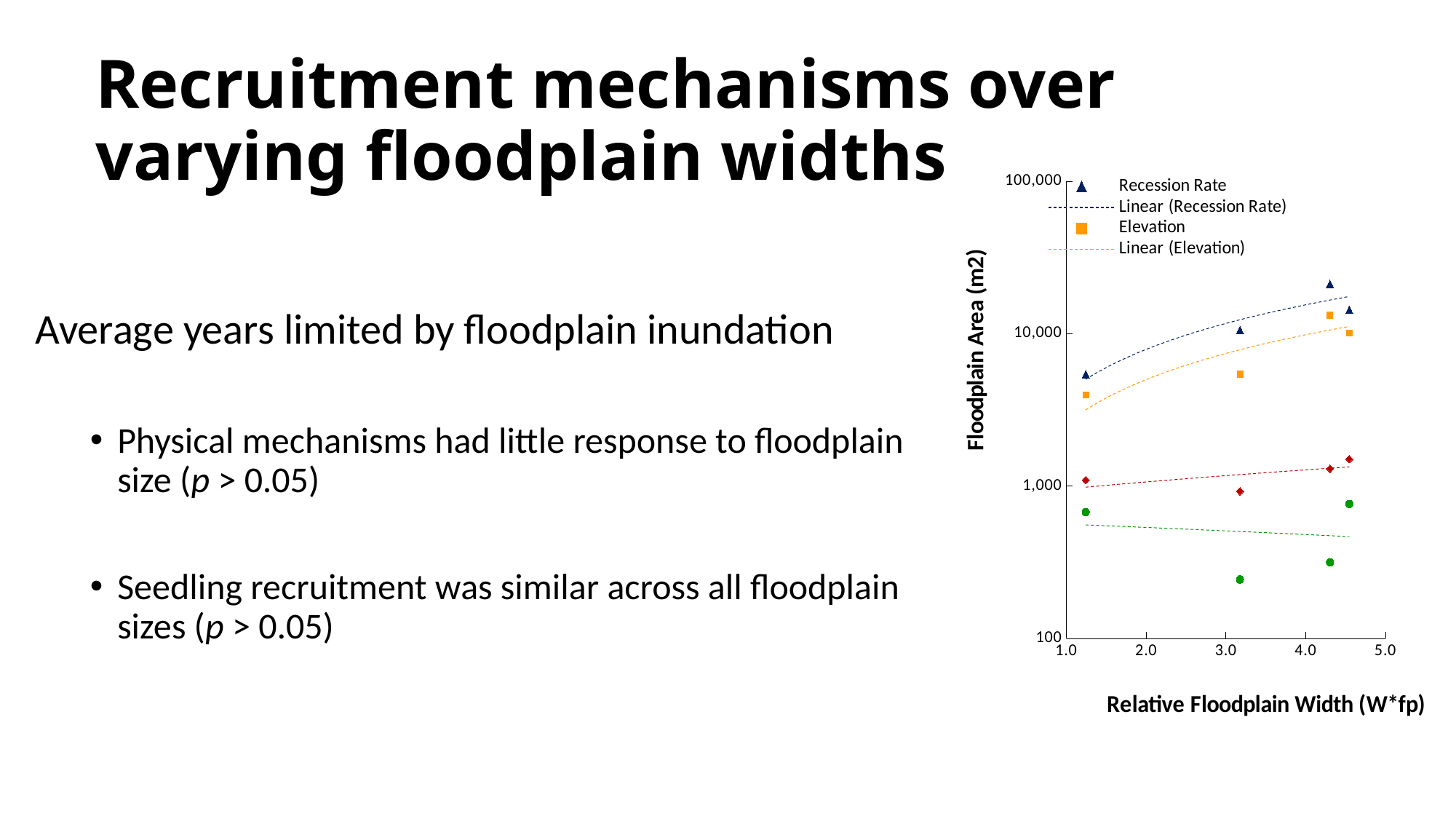
How many Recession Rate data points are plotted on the chart? 4 How many Elevation data points are plotted on the chart? 4 Is the highest Recession Rate point greater or less than 10,000 m2? greater What is the title of the chart's horizontal axis? Relative Floodplain Width (W*fp) What is the title of the chart's vertical axis? Floodplain Area (m2) Does the Linear (Elevation) trendline rise or fall as relative floodplain width increases? rise At a relative floodplain width of about 3.2, which is larger: the Recession Rate value or the Elevation value? Recession Rate What kind of chart is shown on the slide? scatter chart How many entries does the chart legend list? 4 Is the Elevation point at the smallest relative floodplain width greater or less than 10,000 m2? less Does the Linear (Recession Rate) trendline rise or fall as relative floodplain width increases? rise Is the Elevation point at the smallest relative floodplain width greater or less than 1,000 m2? greater